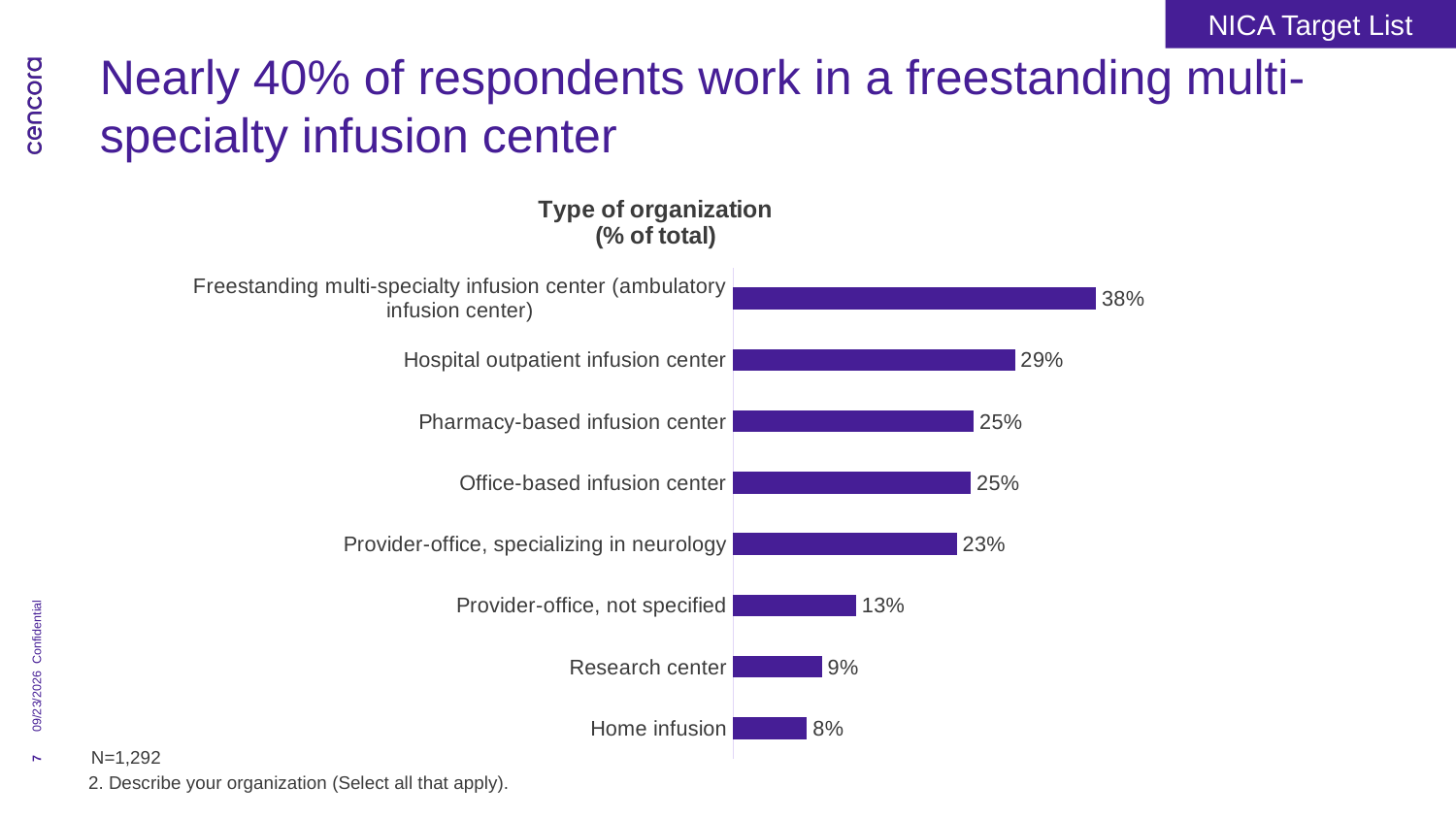
What is the sample size (N) noted below the chart? N=1,292 What kind of chart is used on this slide? Bar chart What is the difference between the Freestanding multi-specialty infusion center value and the Provider-office, not specified value? 25 Which type of organization has the highest percentage? Freestanding multi-specialty infusion center (ambulatory infusion center) What is the difference in percentage points between Hospital outpatient infusion center and Research center? 20 What percentage is shown for Provider-office, specializing in neurology? 23% Which is larger: the value for Provider-office, not specified or the value for Research center? Provider-office, not specified How many types of organization are shown in the chart? 8 What is the value shown for Home infusion? 8% Which type of organization has the lowest percentage? Home infusion What is the title of the chart? Type of organization (% of total) What percentage of respondents work in a hospital outpatient infusion center? 29%